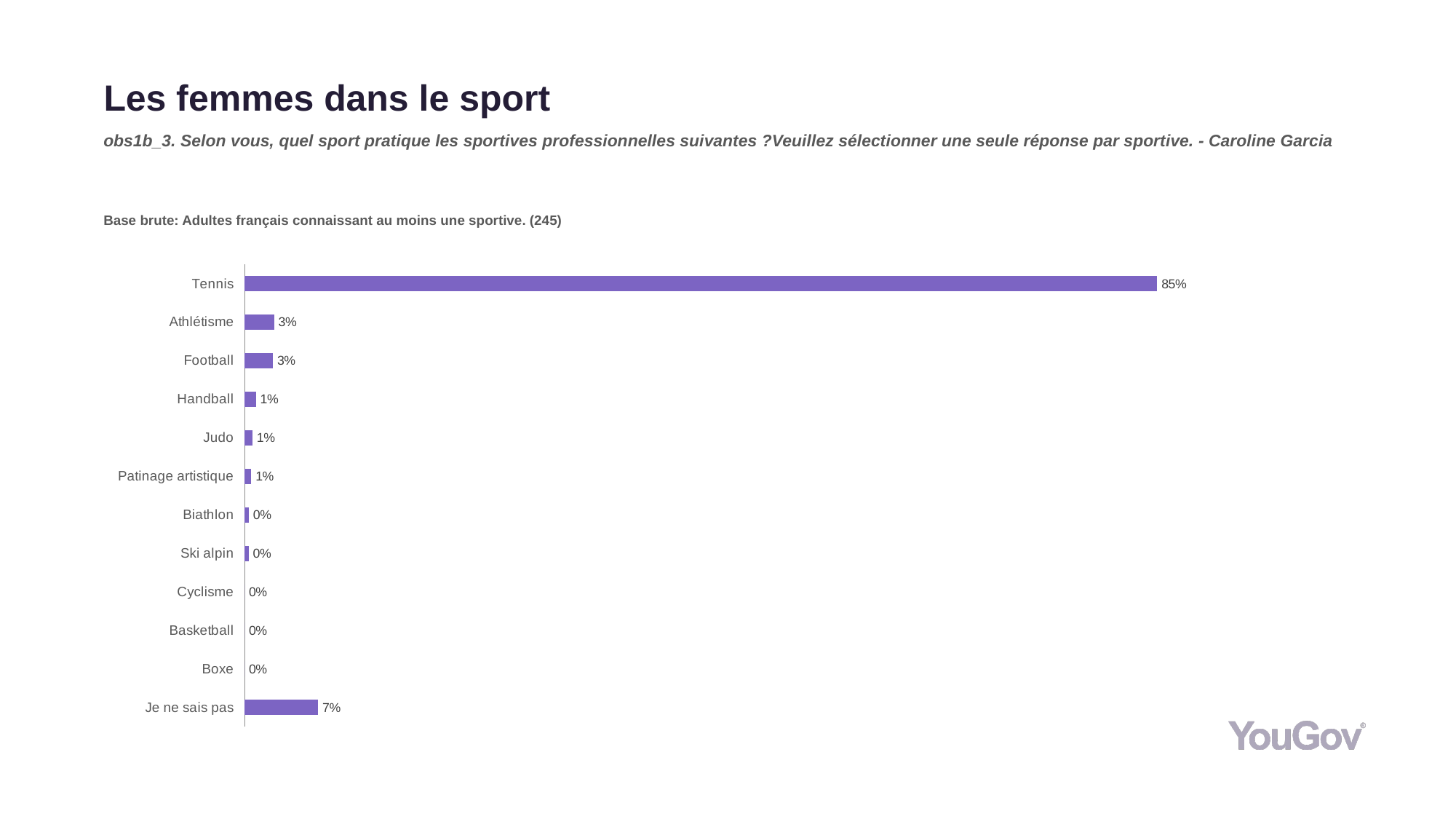
Which is larger, the value for Je ne sais pas or the value for Football? Je ne sais pas What is the value for Handball? 1% What is the base size stated above the chart? 245 Which category has the highest value? Tennis What kind of chart is shown on the slide? Bar chart How many categories have a value of 0%? 5 What is the value for Je ne sais pas? 7% What is the difference between the values for Football and Judo? 2 percentage points What is the value for Tennis? 85% What is the value for Athlétisme? 3% What is the difference between the values for Tennis and Je ne sais pas? 78 percentage points How many categories are shown on the chart? 12